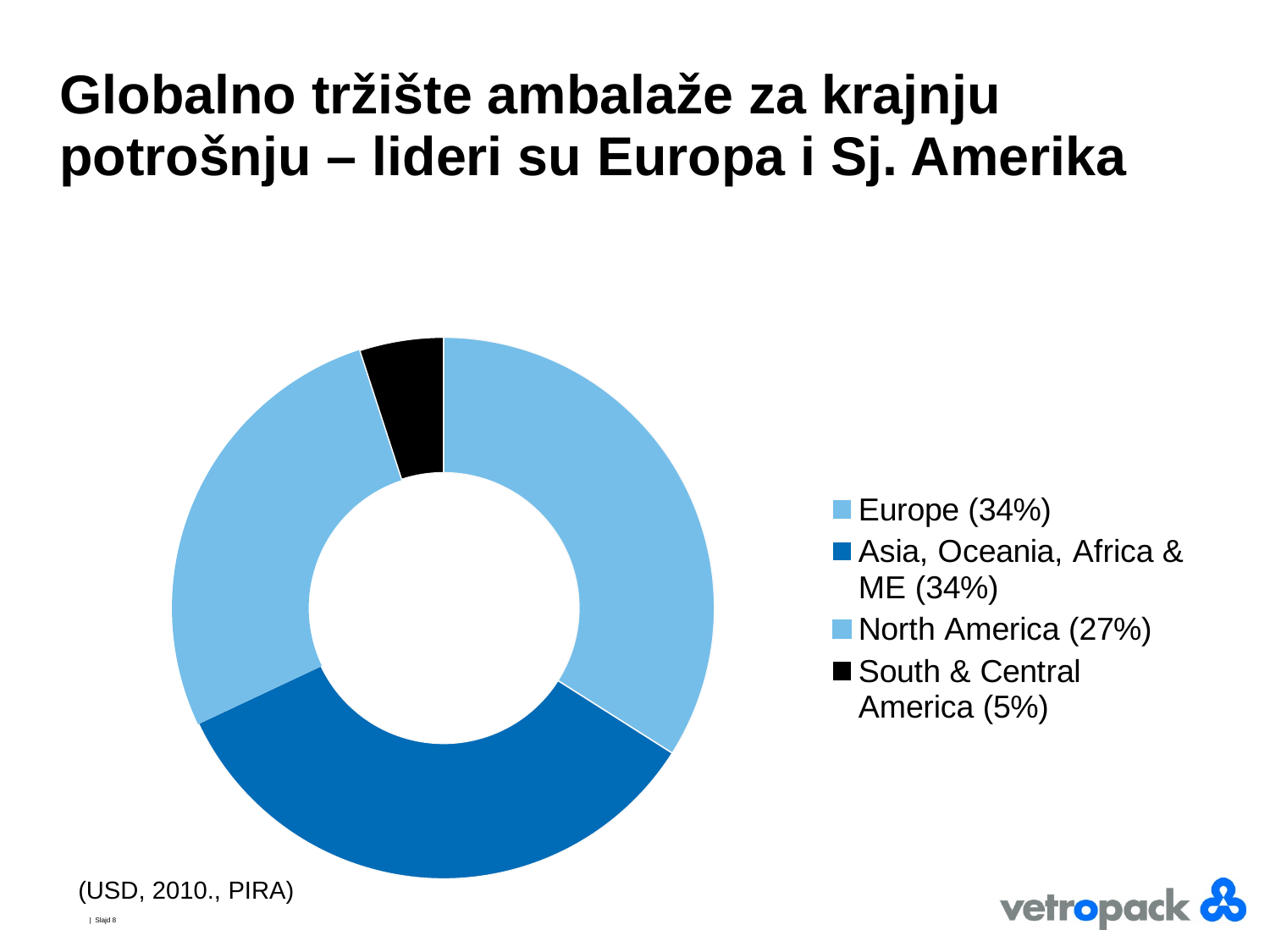
What share does North America hold in the chart? 27% What is the combined share of Europe and North America? 61% What is the difference in percentage points between North America's share and South & Central America's share? 22 percentage points What share of the global consumer packaging market does Europe hold according to the chart? 34% What share does South & Central America hold in the chart? 5% Which slice of the chart is coloured black? South & Central America (5%) What share does Asia, Oceania, Africa & ME hold in the chart? 34% What is the difference in percentage points between Europe's share and North America's share? 7 percentage points Which is larger, the share of North America or the share of South & Central America? North America Which region has the smallest share in the chart? South & Central America What kind of chart is shown on the slide? doughnut chart How many regions (slices) does the chart show? 4